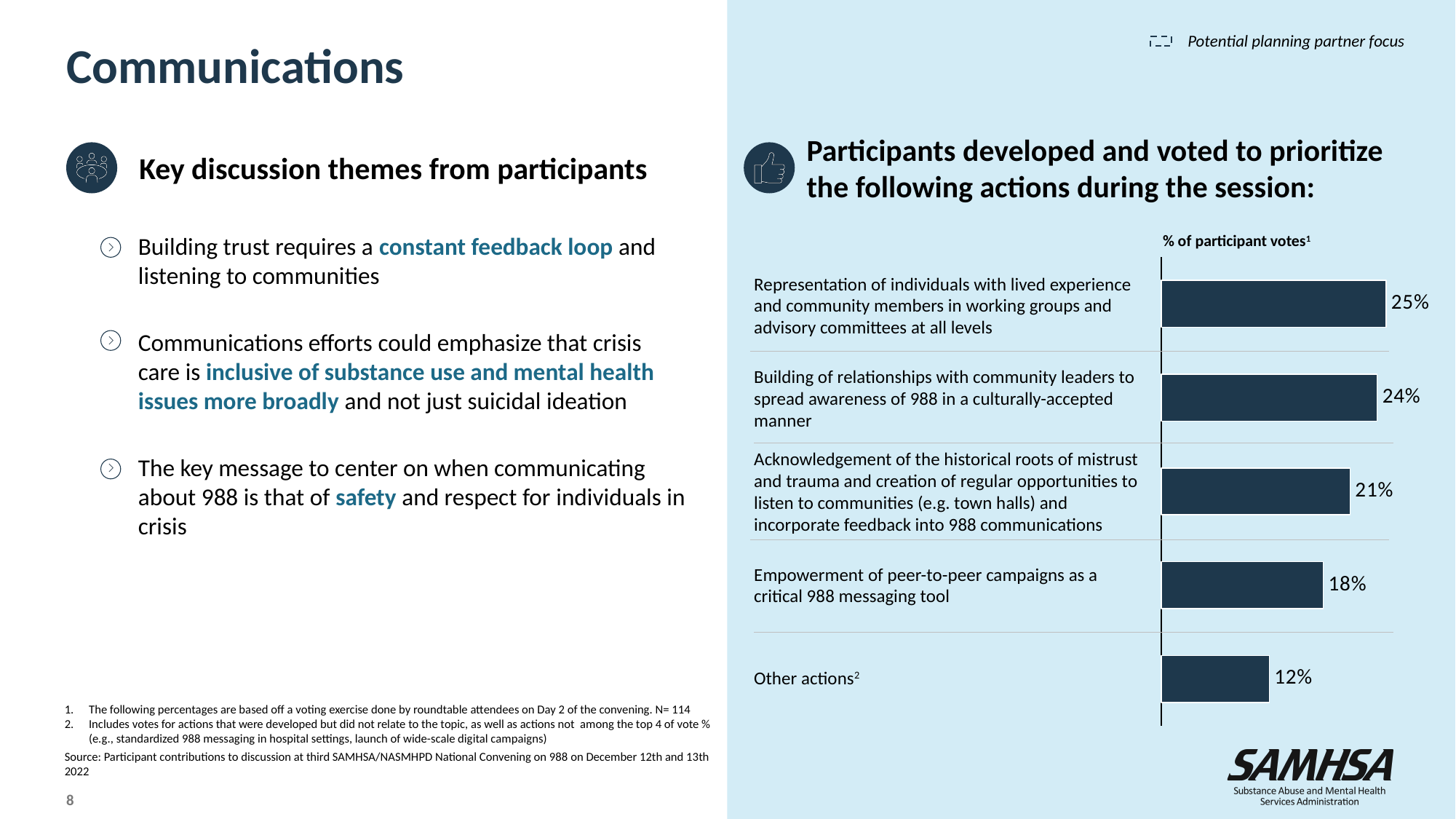
Which category received the lowest share of participant votes? Other actions Which received more participant votes: 'Empowerment of peer-to-peer campaigns as a critical 988 messaging tool' or 'Other actions'? Empowerment of peer-to-peer campaigns as a critical 988 messaging tool What is the difference in participant votes between 'Acknowledgement of the historical roots of mistrust...' and 'Empowerment of peer-to-peer campaigns...'? 3% Which action received the highest share of participant votes? Representation of individuals with lived experience and community members in working groups and advisory committees at all levels What is the label above the bars in the chart? % of participant votes What percentage of participant votes did 'Empowerment of peer-to-peer campaigns as a critical 988 messaging tool' receive? 18% What kind of chart is used to show the % of participant votes? Bar chart Do the values in the chart rise or fall from the top category to the bottom category? Fall What is the difference in participant votes between 'Representation of individuals with lived experience...' (25%) and 'Other actions' (12%)? 13% What percentage of participant votes did 'Other actions' receive? 12% How many categories are shown in the bar chart? 5 What percentage of participant votes did 'Building of relationships with community leaders to spread awareness of 988 in a culturally-accepted manner' receive? 24%